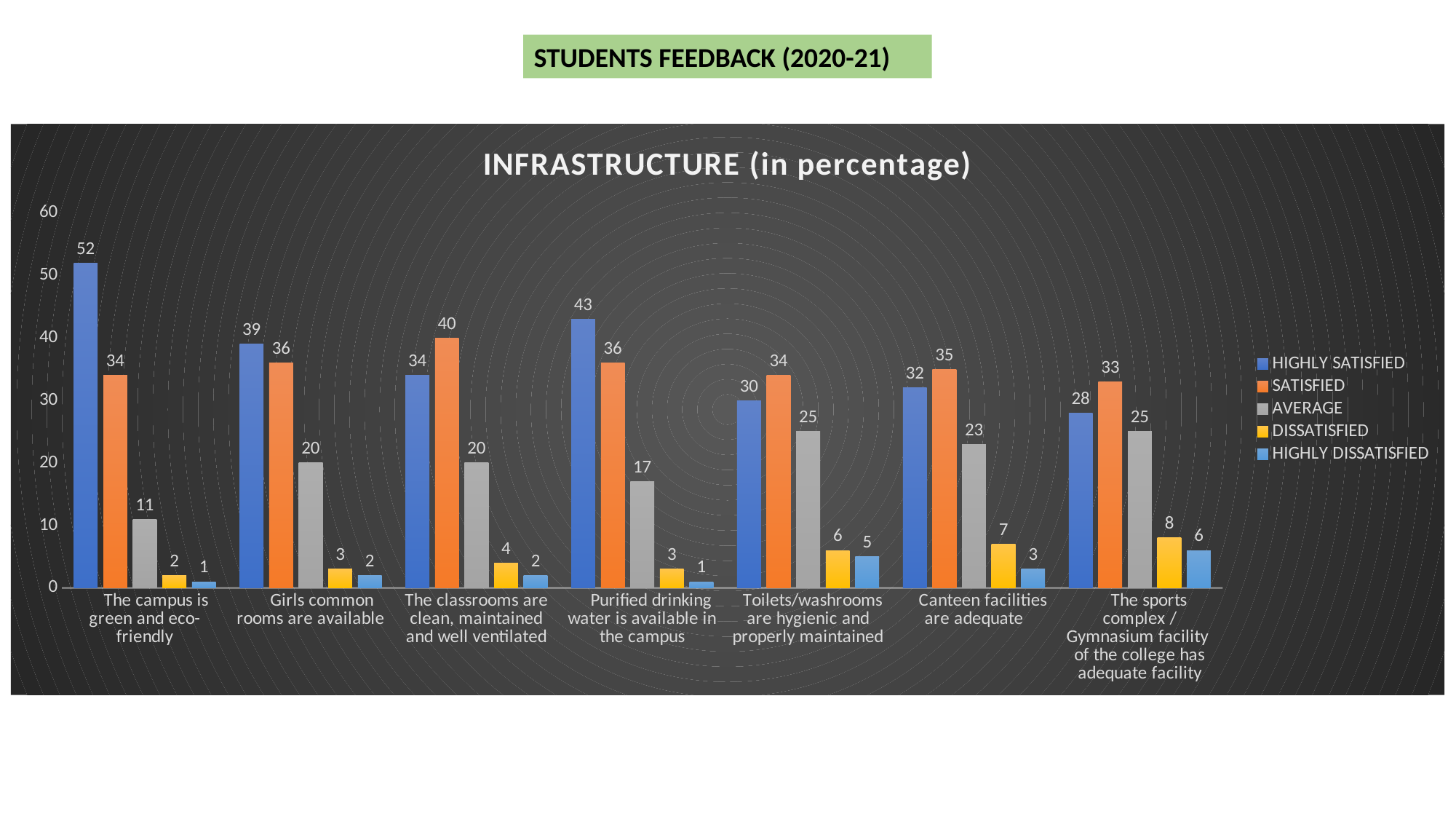
How many categories are shown on the x axis? 7 What is the difference between the HIGHLY SATISFIED and SATISFIED values for "Purified drinking water is available in the campus"? 7 Which category has the lowest HIGHLY SATISFIED value? The sports complex / Gymnasium facility of the college has adequate facility What kind of chart is shown on the slide? Bar chart Which is larger for "Canteen facilities are adequate": HIGHLY SATISFIED or SATISFIED? SATISFIED What is the DISSATISFIED value for "The sports complex / Gymnasium facility of the college has adequate facility"? 8 What is the HIGHLY SATISFIED value for "The campus is green and eco-friendly"? 52 What is the SATISFIED value for "The classrooms are clean, maintained and well ventilated"? 40 What is the title of the chart? INFRASTRUCTURE (in percentage) How many series does the legend list? 5 What is the AVERAGE value for "Toilets/washrooms are hygienic and properly maintained"? 25 Which category has the highest HIGHLY SATISFIED value? The campus is green and eco-friendly